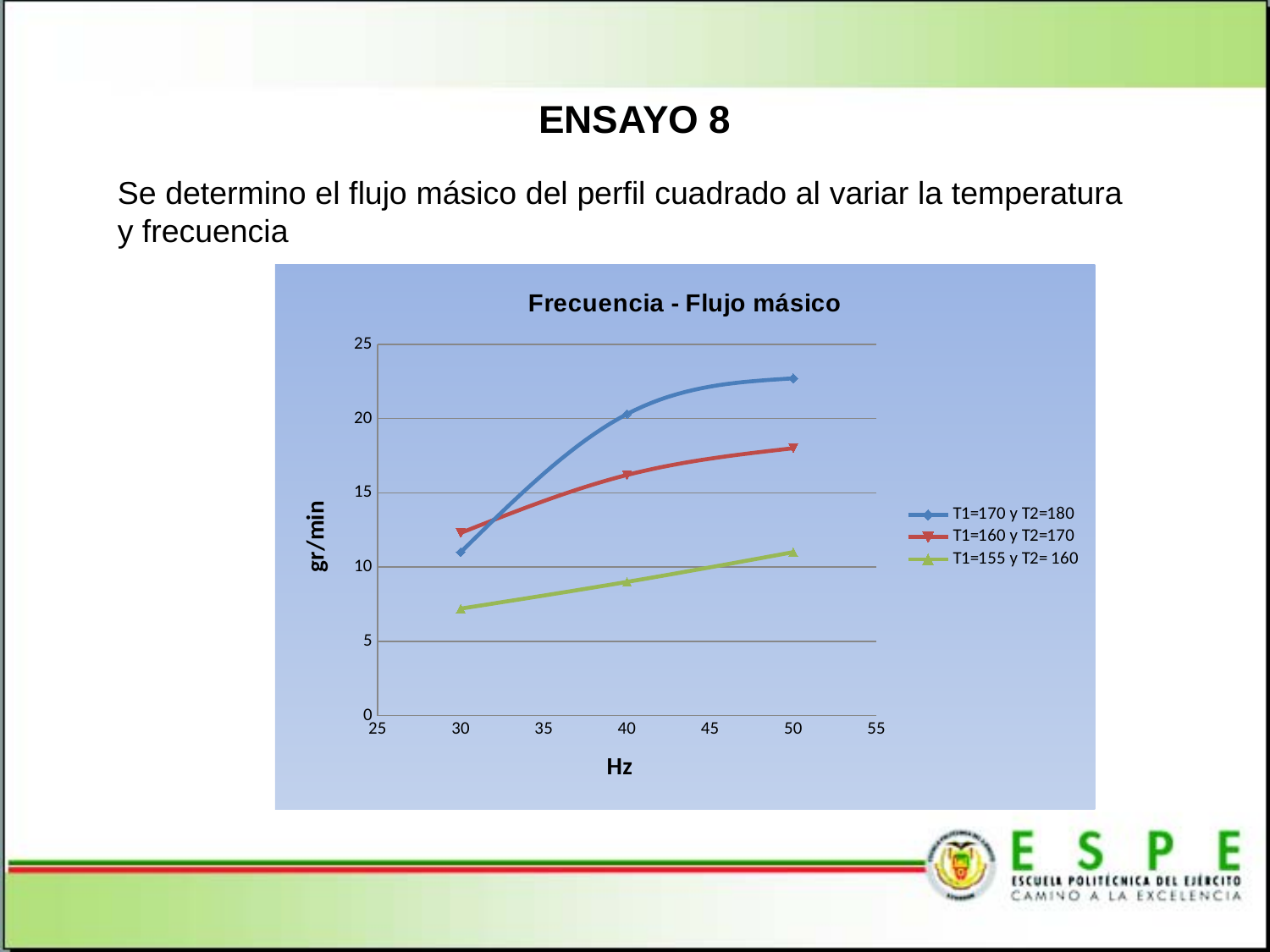
Is the value for T1=170 y T2=180 at 50 Hz greater or less than 20? greater Which series has the highest value at 50 Hz? T1=170 y T2=180 How many series does the legend list? 3 Which series has the lowest value at 50 Hz? T1=155 y T2= 160 At 40 Hz, which series has the larger value, T1=170 y T2=180 or T1=155 y T2= 160? T1=170 y T2=180 Is the value for T1=155 y T2= 160 at 30 Hz greater or less than 10? less Is the value for T1=160 y T2=170 at 50 Hz greater or less than 20? less At 30 Hz, which series has the larger value, T1=170 y T2=180 or T1=160 y T2=170? T1=160 y T2=170 How many data points are plotted for the T1=170 y T2=180 series? 3 What type of chart is shown on the slide? line chart Do the values of the T1=155 y T2= 160 series rise or fall as frequency increases from 30 to 50 Hz? rise What is the label of the vertical axis of the chart? gr/min